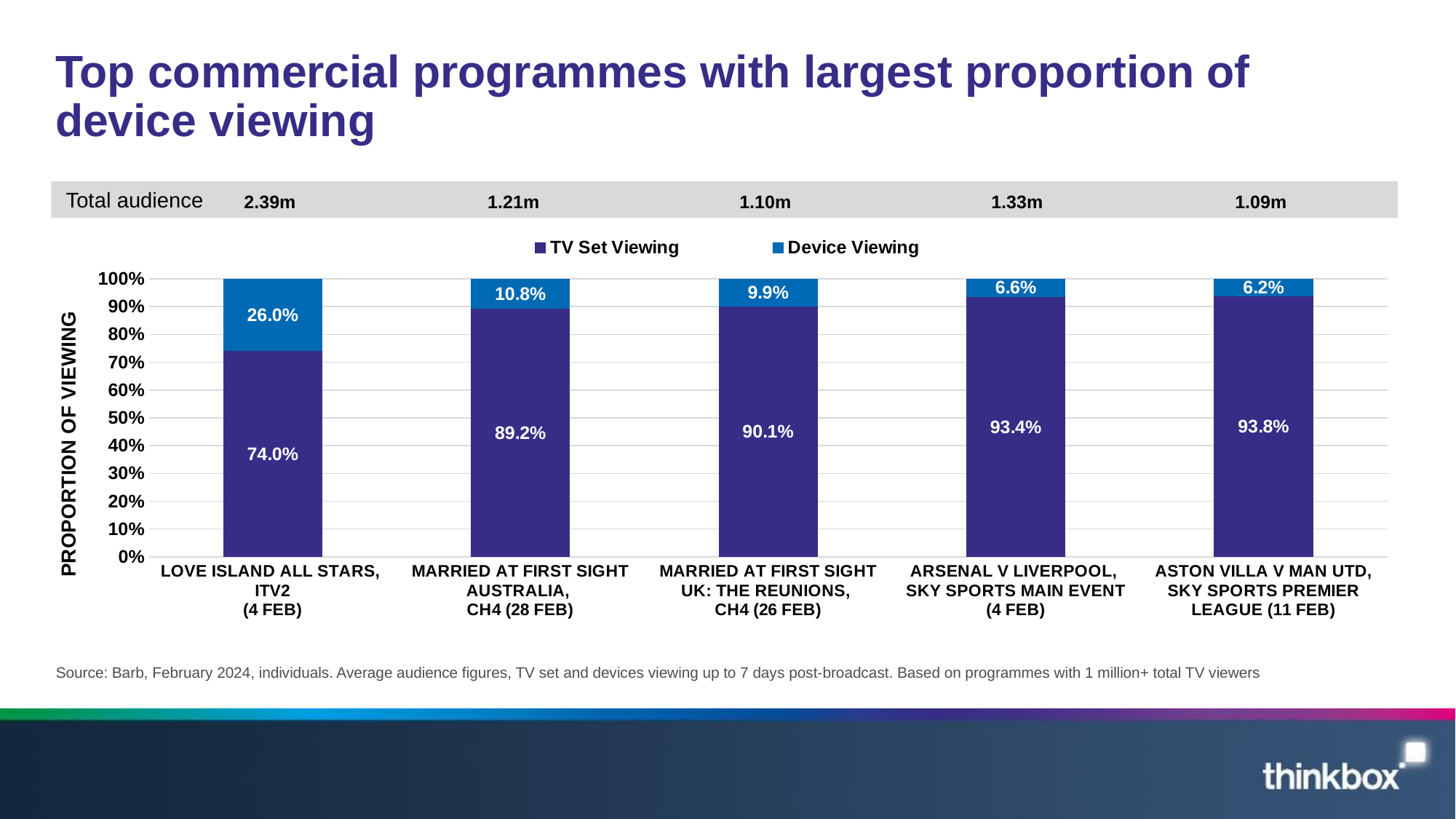
What is the Device Viewing share for Arsenal v Liverpool, Sky Sports Main Event (4 Feb)? 6.6% How many programmes are shown on the chart? 5 Which programme has the highest Device Viewing share? Love Island All Stars, ITV2 (4 Feb) What is the Device Viewing share for Love Island All Stars, ITV2 (4 Feb)? 26.0% Which has a larger TV Set Viewing share: Married at First Sight UK: The Reunions or Arsenal v Liverpool? Arsenal v Liverpool What kind of chart is shown on the slide? Stacked bar chart Does the Device Viewing share rise or fall moving from left to right across the programmes? Fall Which programme has the lowest Device Viewing share? Aston Villa v Man Utd, Sky Sports Premier League (11 Feb) How many series does the legend list? 2 What is the total audience shown for Married at First Sight UK: The Reunions, CH4 (26 Feb)? 1.10m What is the difference in Device Viewing share between Love Island All Stars and Married at First Sight Australia? 15.2% What is the TV Set Viewing share for Married at First Sight Australia, CH4 (28 Feb)? 89.2%